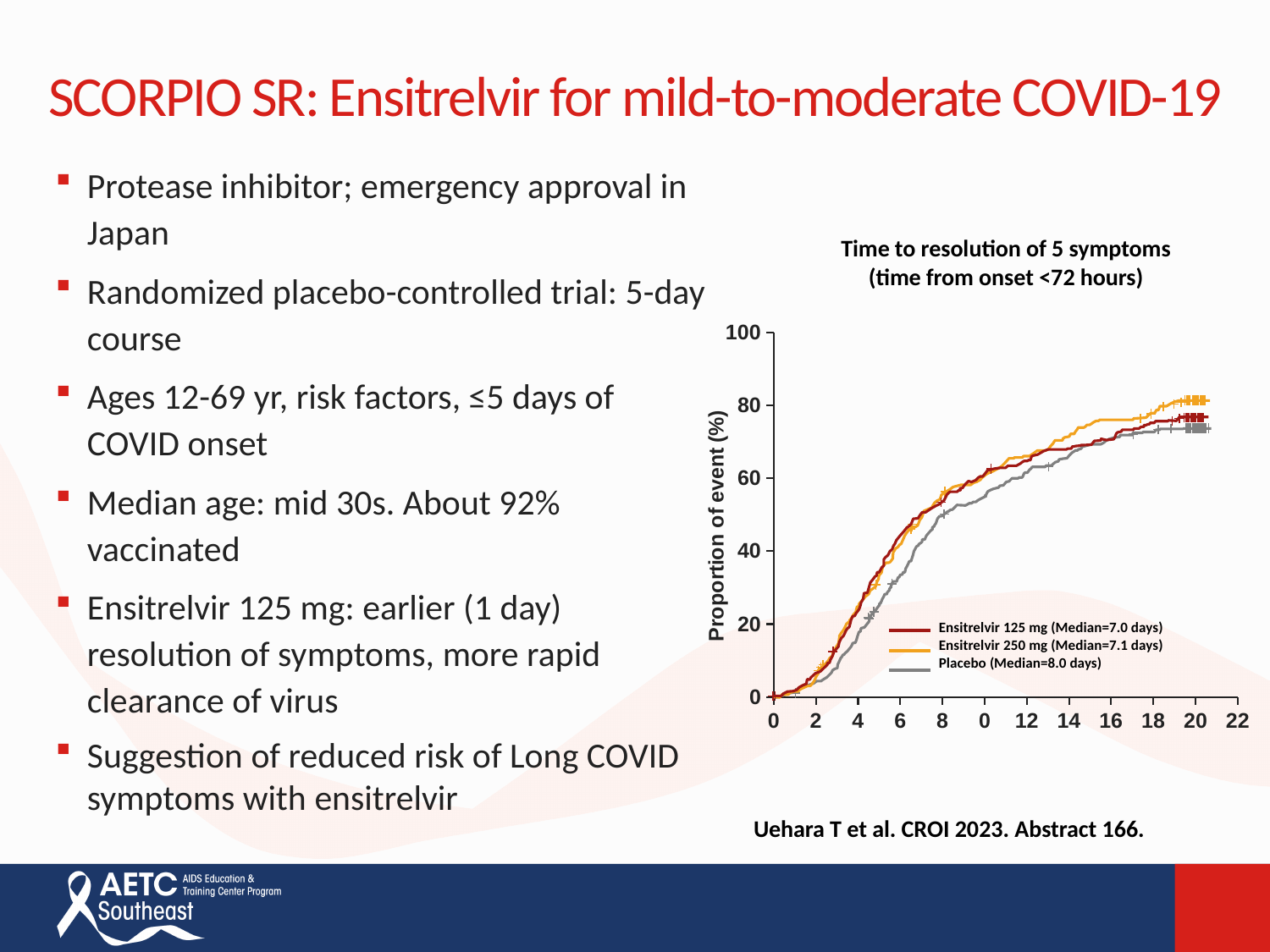
What kind of chart is shown on the slide? Line chart Which curve is lowest at day 10, Placebo or Ensitrelvir 125 mg? Placebo Which group has the longest median time to resolution of symptoms? Placebo Is the proportion of event for Ensitrelvir 125 mg at day 8 greater or less than 40? greater Is the proportion of event for Placebo at day 20 greater or less than 80? less Which group has the shortest median time to resolution of symptoms? Ensitrelvir 125 mg What is the median time to resolution for Ensitrelvir 125 mg according to the legend? 7.0 days How many series does the chart legend list? 3 Do the curves rise or fall as time increases along the x axis? Rise What is the title of the chart? Time to resolution of 5 symptoms (time from onset <72 hours) What is the median time to resolution for Ensitrelvir 250 mg according to the legend? 7.1 days What is the median time to resolution for Placebo according to the legend? 8.0 days